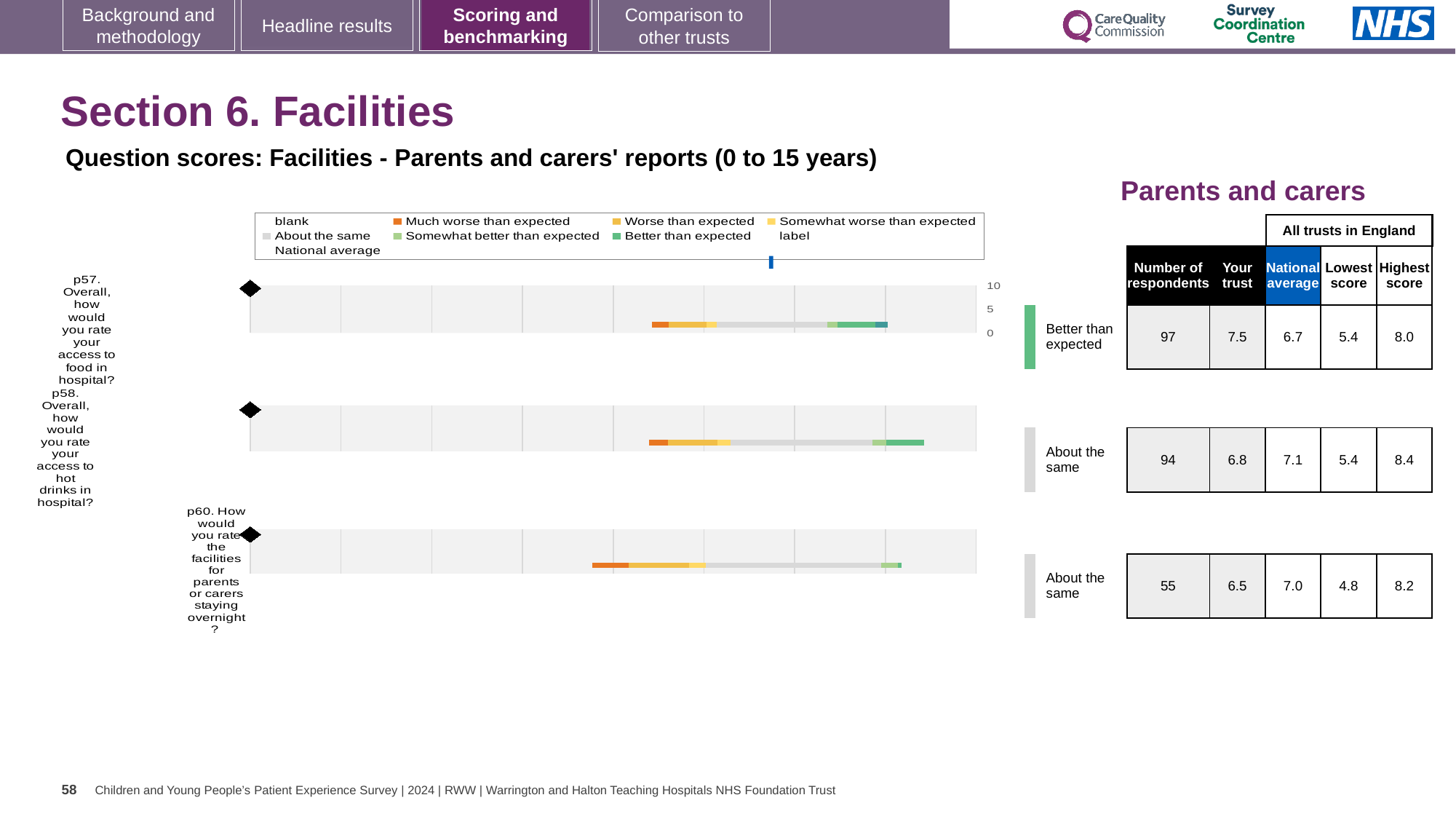
What is the highest score across all trusts in England for p58 (access to hot drinks in hospital)? 8.4 For p58 (access to hot drinks in hospital), what is the difference between the highest score and the lowest score? 3.0 For p57 (access to food in hospital), what is the 'Your trust' score shown in the table? 7.5 How many respondents are listed for p60 (facilities for parents or carers staying overnight)? 55 How many question charts are shown on the slide? 3 Which question is rated 'Better than expected' on the slide? p57. Overall, how would you rate your access to food in hospital? What kind of chart is used to show the benchmarking for p57 (access to food in hospital)? bar chart For p58 (access to hot drinks in hospital), what is the national average score? 7.1 What is the lowest score across all trusts in England for p60 (facilities for parents or carers staying overnight)? 4.8 For p57 (access to food in hospital), which is larger: the 'Your trust' score or the national average? Your trust What is the subtitle above the charts? Question scores: Facilities - Parents and carers' reports (0 to 15 years) Which question has the highest number of respondents? p57. Overall, how would you rate your access to food in hospital?